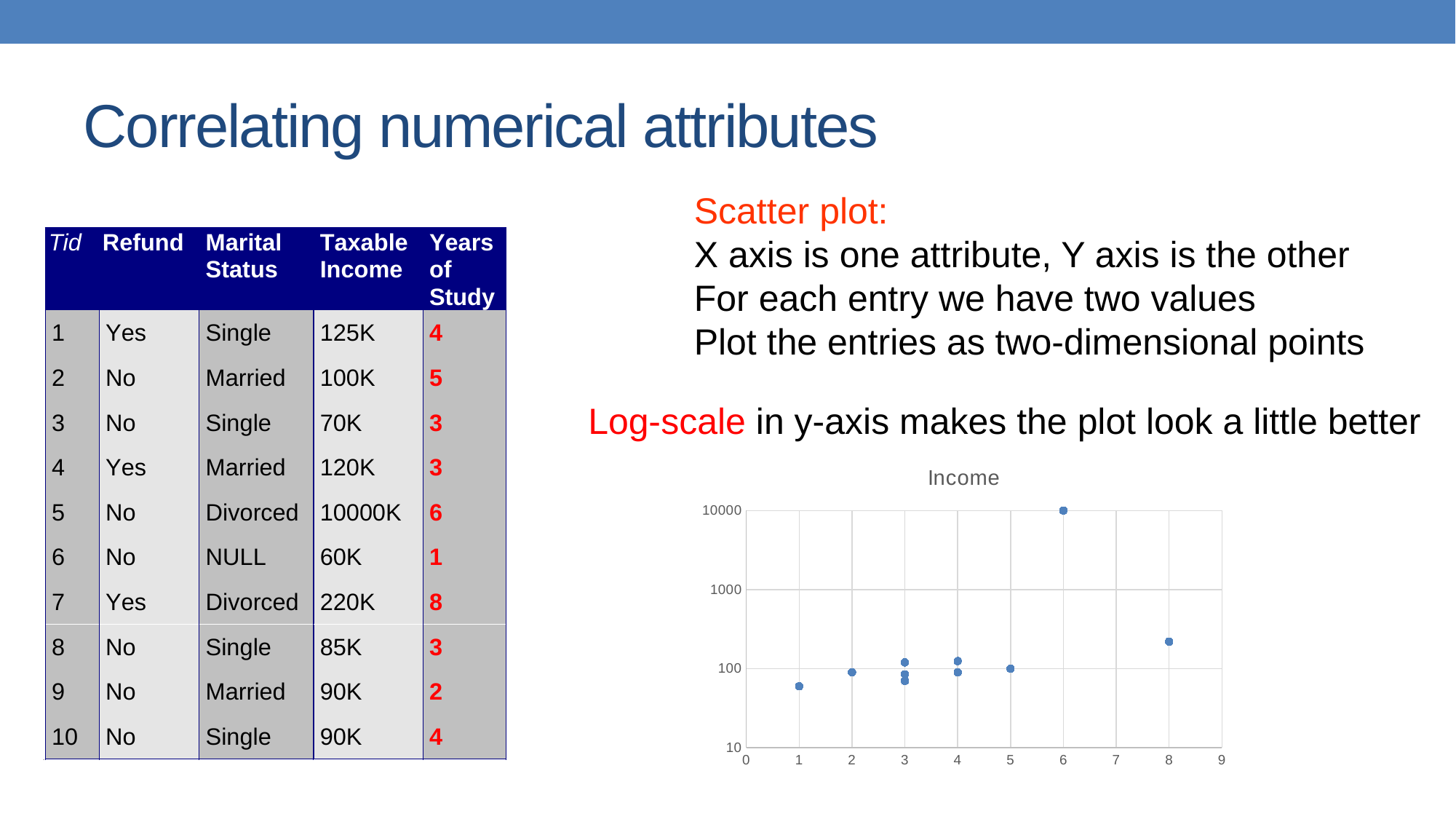
What is the y value of the point at x = 6? 10000 What is the title of the chart? Income Is the value of the point at x = 8 greater or less than 100? greater Which point has the larger y value, the one at x = 6 or the one at x = 8? x = 6 How many points are plotted in the scatter plot? 10 What is the y value of the point at x = 5? 100 Is the value of the point at x = 6 greater or less than 1000? greater What kind of chart is shown on the slide? scatter plot How many points are plotted at x = 3? 3 Which point has the larger y value, the one at x = 8 or the one at x = 5? x = 8 At which x value is the highest point in the scatter plot? 6 Is the value of the point at x = 1 greater or less than 100? less